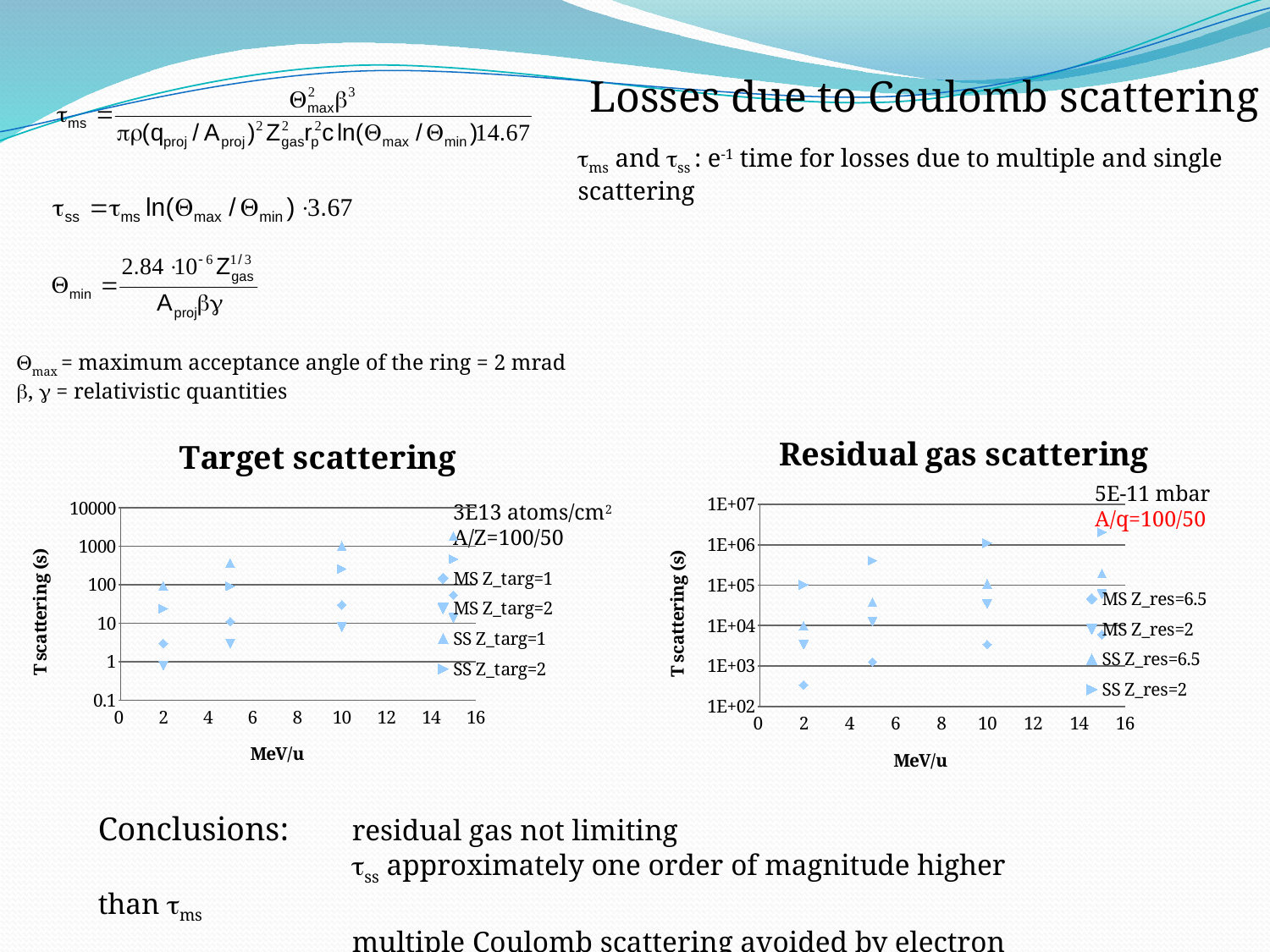
In the Residual gas scattering chart, do the T scattering values rise or fall as MeV/u increases? rise In the Residual gas scattering chart, is the value for MS Z_res=6.5 at 2 MeV/u greater or less than 1E+03? less How many series does the legend of the Target scattering chart list? 4 In the Target scattering chart, is the value for SS Z_targ=2 at 15 MeV/u greater or less than 100? greater In the Residual gas scattering chart, which series has the lowest T scattering values? MS Z_res=6.5 In the Residual gas scattering chart, is the value for SS Z_res=2 at 15 MeV/u greater or less than 1E+06? greater What kind of chart is the Target scattering chart? scatter chart In the Target scattering chart, which series has the highest T scattering values? SS Z_targ=1 How many series does the legend of the Residual gas scattering chart list? 4 What is the x-axis label of the Residual gas scattering chart? MeV/u In the Target scattering chart, do the T scattering values rise or fall as MeV/u increases? rise